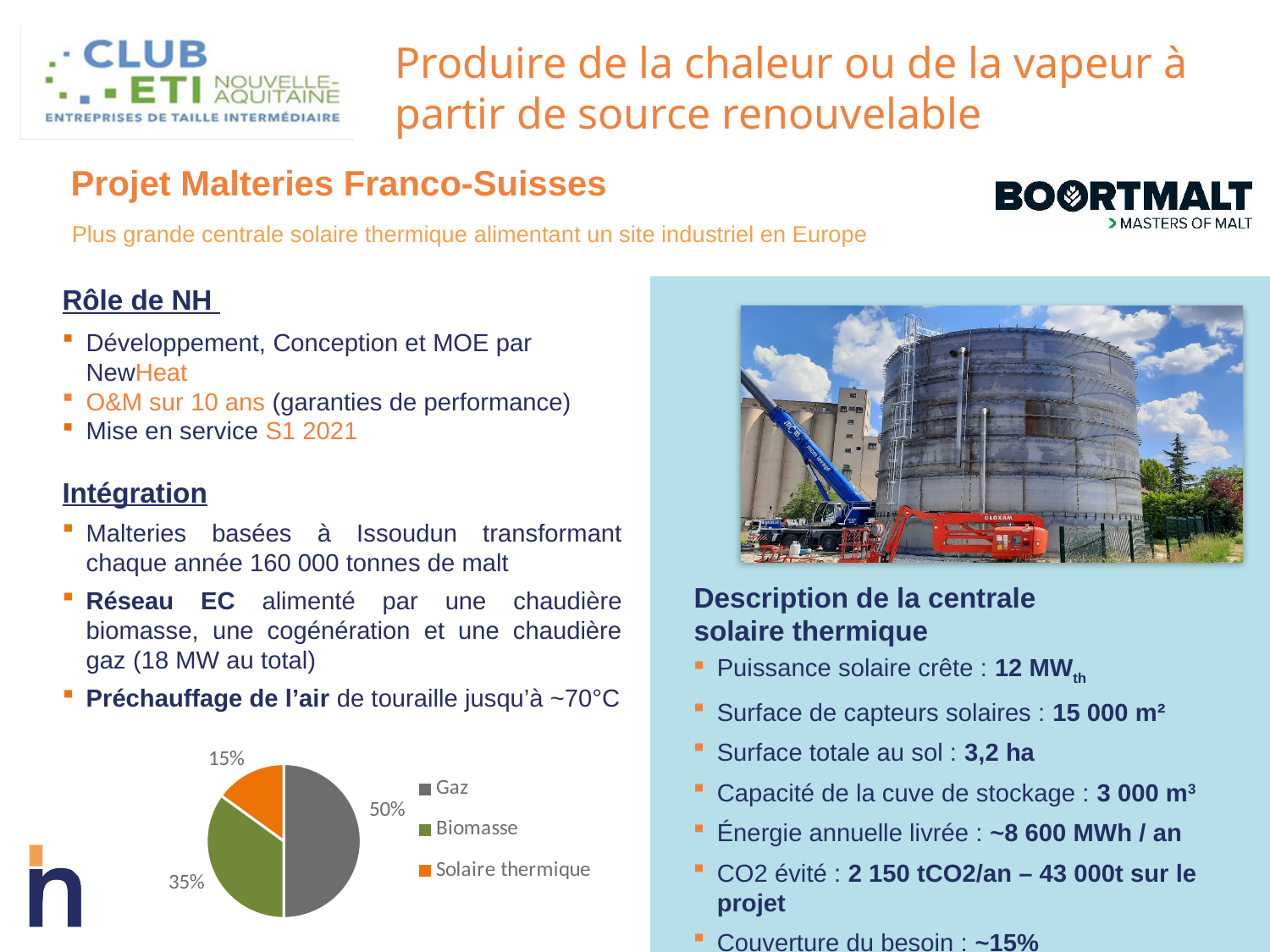
What share of the pie chart does Solaire thermique represent? 15% How many slices does the pie chart have? 3 How many entries does the pie chart legend list? 3 Which category has the largest slice in the pie chart? Gaz What share of the pie chart does Biomasse represent? 35% What is the difference in percentage points between the Gaz slice and the Biomasse slice? 15 What share of the pie chart does Gaz represent? 50% Which category has the smallest slice in the pie chart? Solaire thermique What is the difference in percentage points between the Biomasse slice and the Solaire thermique slice? 20 What colour is the Solaire thermique slice in the pie chart? orange Which is larger in the pie chart, Biomasse or Solaire thermique? Biomasse What kind of chart is shown at the bottom left of the slide? pie chart